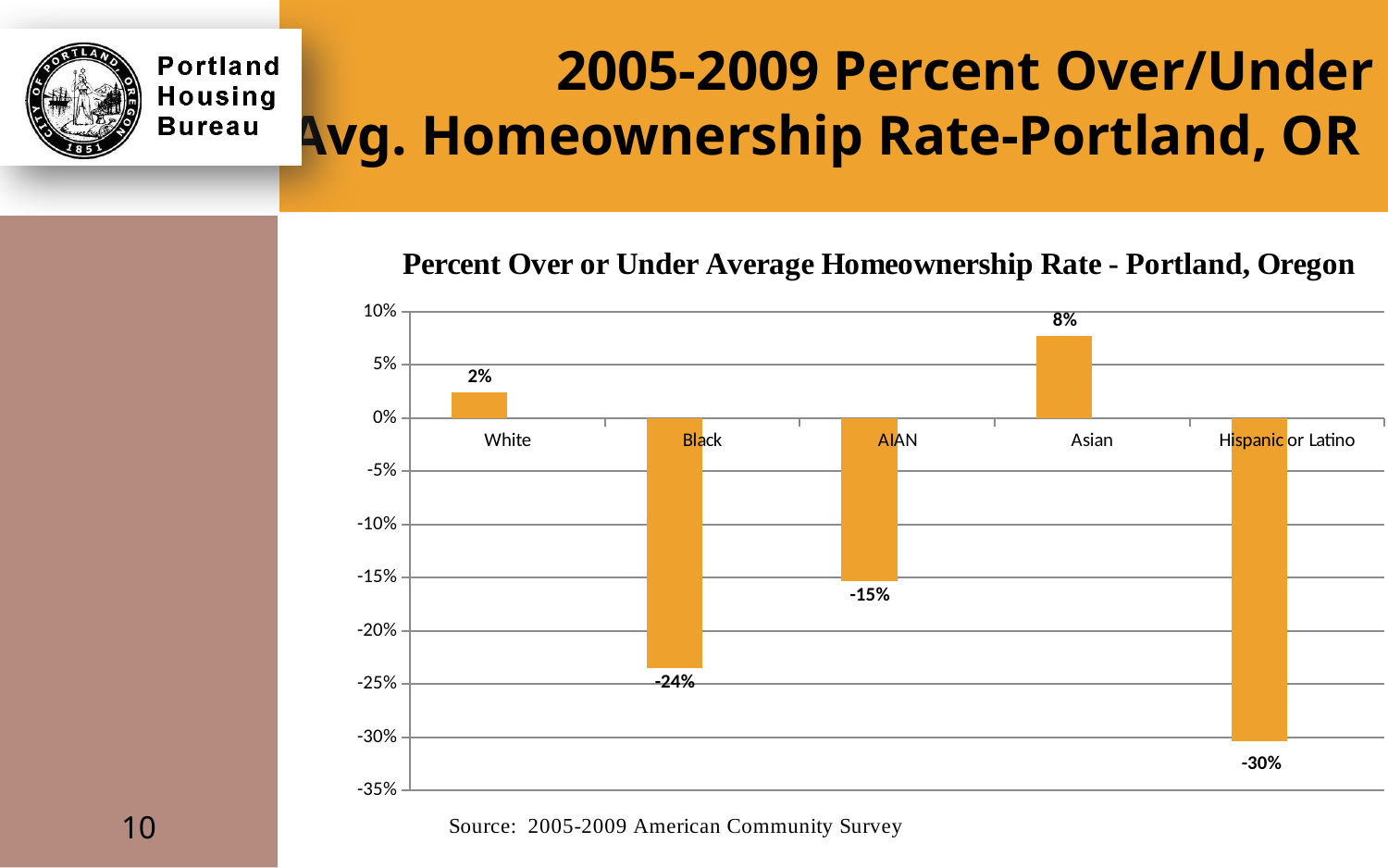
Which category has the highest value? Asian What is the value for Asian? 8% What is the value for White? 2% What is the difference between the values for Asian and White? 6% What is the value for Hispanic or Latino? -30% What kind of chart is shown on the slide? Bar chart Which is larger, the value for Black or the value for AIAN? AIAN Which category has the lowest value? Hispanic or Latino What is the title of the chart? Percent Over or Under Average Homeownership Rate - Portland, Oregon What is the value for Black? -24% How many categories are shown on the x axis? 5 What is the value for AIAN? -15%